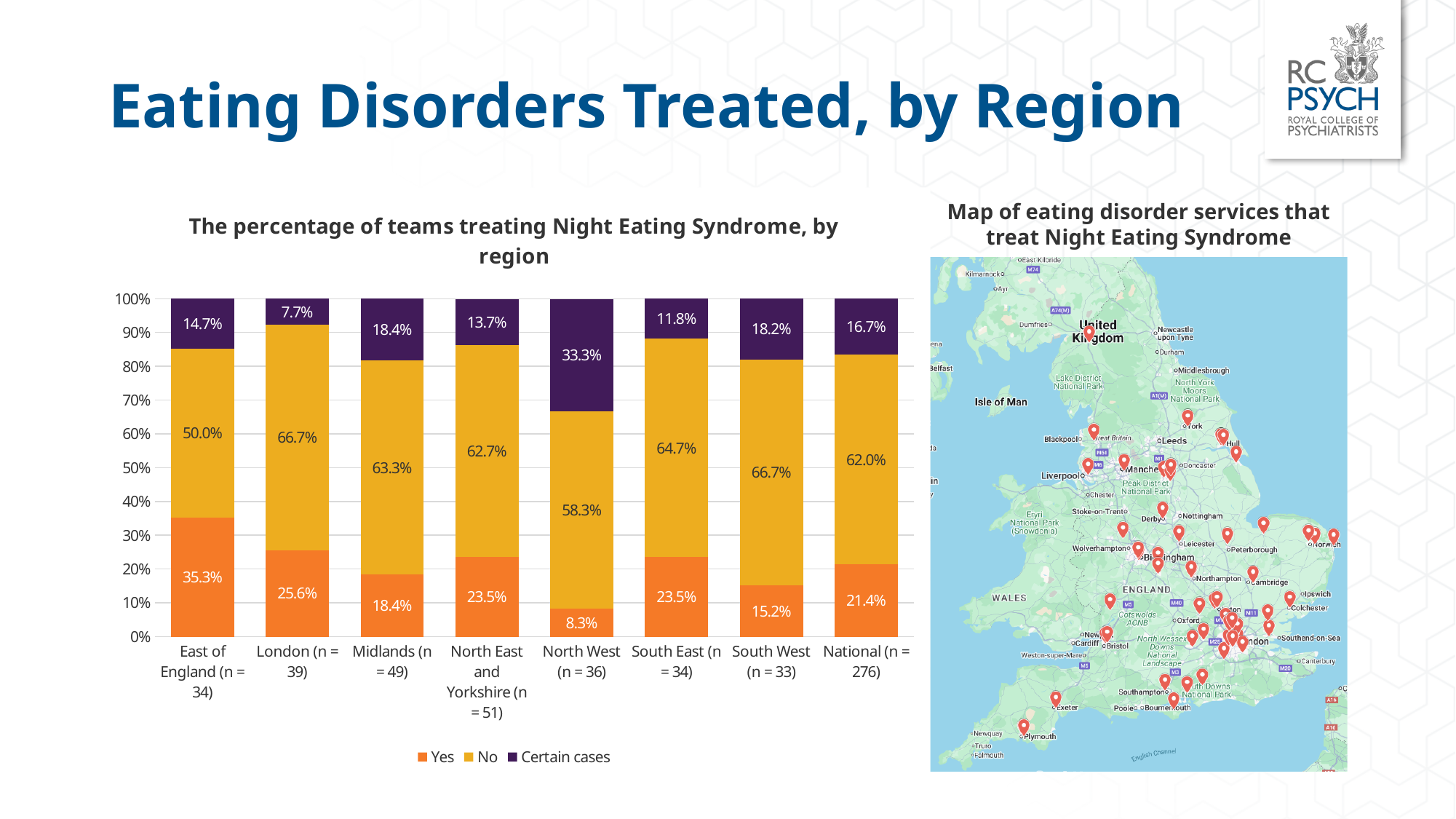
Which region has the lowest 'Yes' percentage? North West How many series does the legend of the bar chart list? 3 What are the three legend entries in the bar chart? Yes, No, Certain cases What is the 'No' percentage for the National category? 62.0% What kind of chart is used to show the percentage of teams treating Night Eating Syndrome by region? Stacked bar chart Which region has the highest 'Yes' percentage? East of England What percentage of teams in the East of England answered 'Yes' to treating Night Eating Syndrome? 35.3% Which is larger: the 'No' percentage for London or the 'No' percentage for Midlands? London How many region categories are shown on the x axis of the bar chart? 8 Which region has the lowest 'Certain cases' percentage? London What is the 'Certain cases' percentage for the North West region? 33.3% What is the difference in percentage points between the 'Yes' value for East of England and the 'Yes' value for North West? 27.0 percentage points